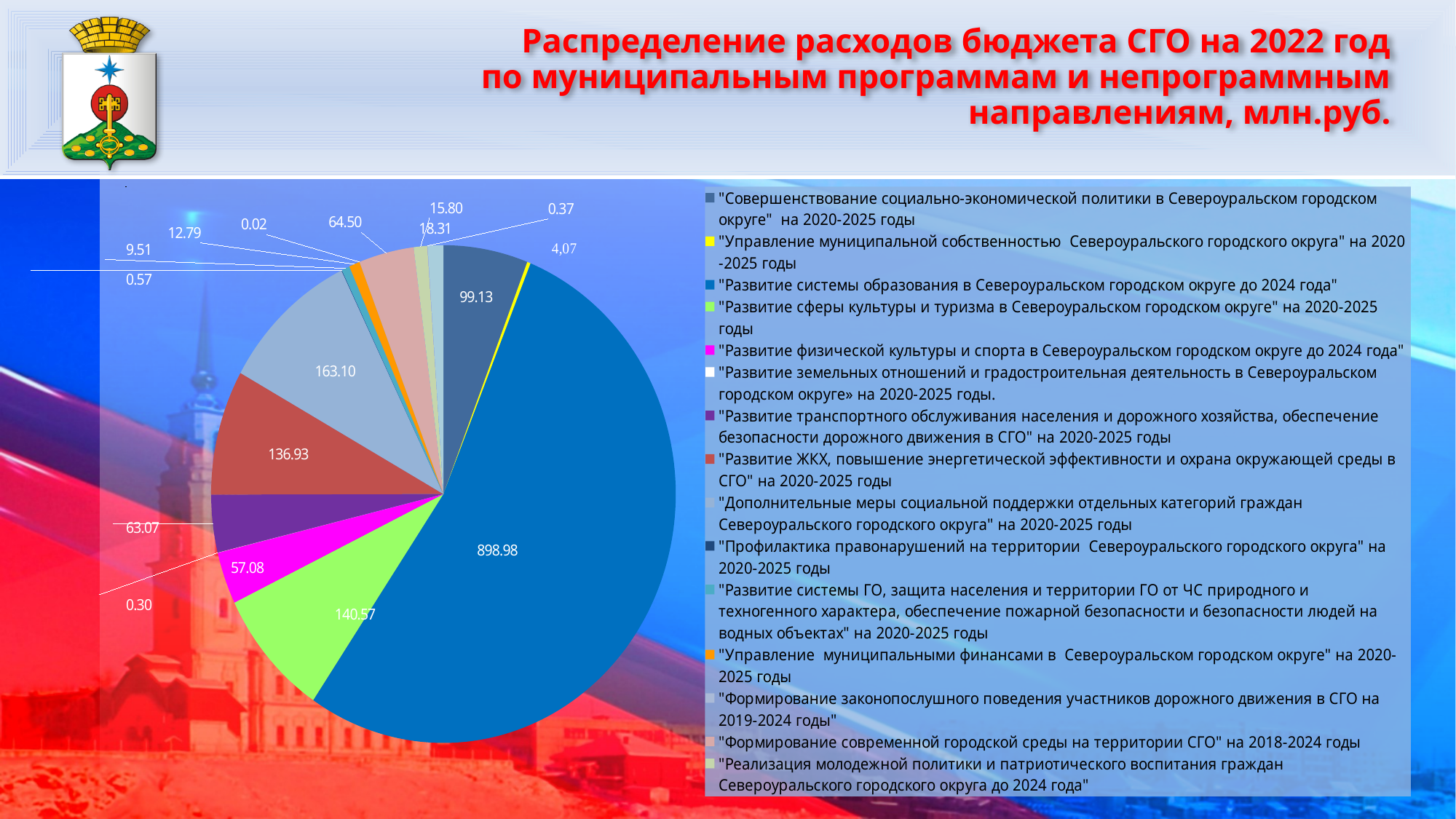
Which is larger: the value for "Развитие сферы культуры и туризма..." or the value for "Развитие физической культуры и спорта..."? "Развитие сферы культуры и туризма..." What is the value for "Совершенствование социально-экономической политики в Североуральском городском округе" на 2020-2025 годы? 99.13 What is the value for "Развитие системы образования в Североуральском городском округе до 2024 года"? 898.98 What is the value for "Развитие ЖКХ, повышение энергетической эффективности и охрана окружающей среды в СГО" на 2020-2025 годы? 136.93 What is the value for "Развитие сферы культуры и туризма в Североуральском городском округе" на 2020-2025 годы? 140.57 What is the difference between the values for "Дополнительные меры социальной поддержки..." and "Развитие ЖКХ..."? 26.17 What kind of chart is shown on the slide? pie chart Which programme has the largest slice of the pie? "Развитие системы образования в Североуральском городском округе до 2024 года" What is the title of the slide containing the chart? Распределение расходов бюджета СГО на 2022 год по муниципальным программам и непрограммным направлениям, млн.руб. What is the value for "Развитие физической культуры и спорта в Североуральском городском округе до 2024 года"? 57.08 What is the value for "Дополнительные меры социальной поддержки отдельных категорий граждан Североуральского городского округа" на 2020-2025 годы? 163.10 What is the smallest value labelled on the pie chart? 0.02